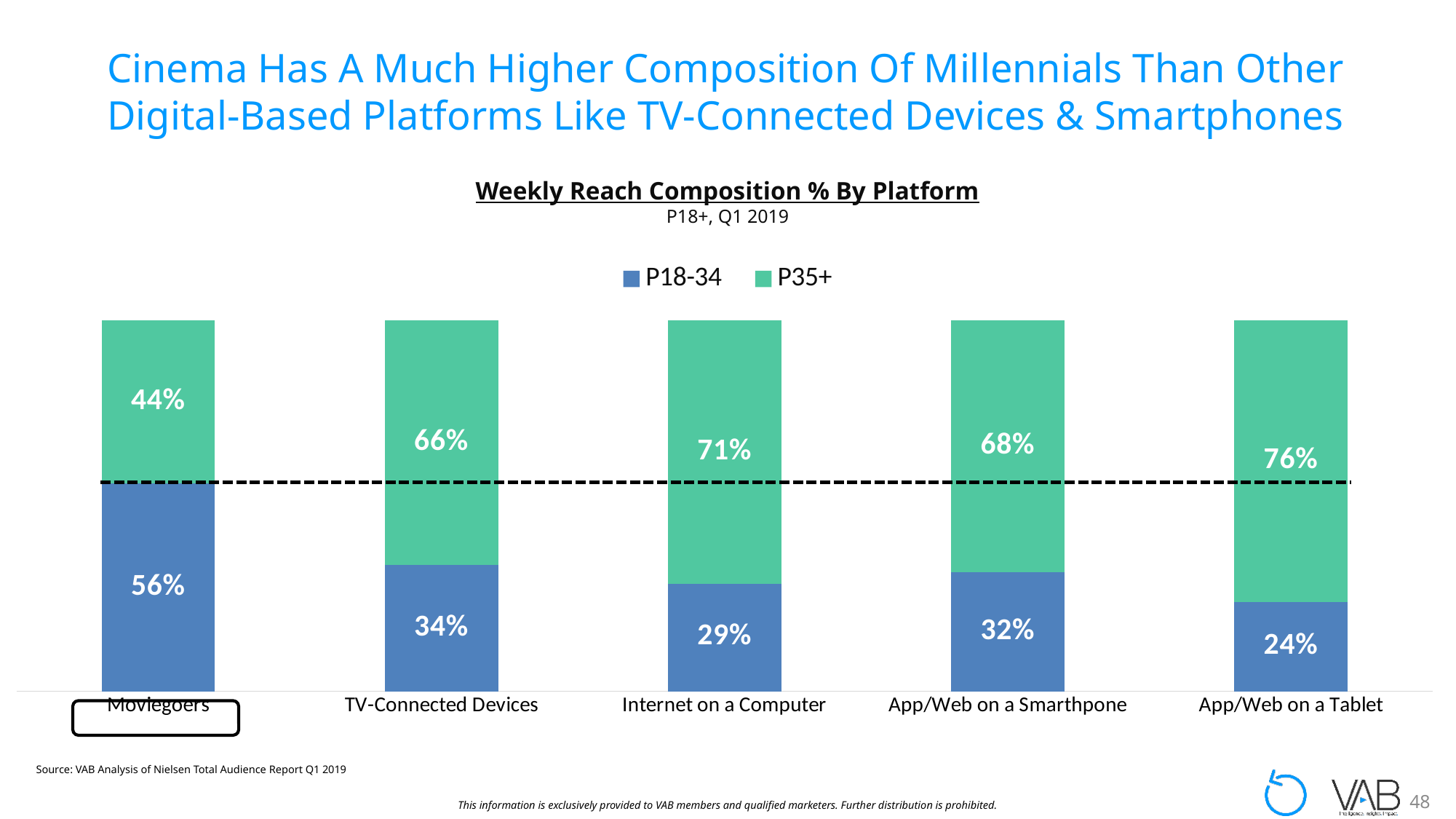
What is the P18-34 value for Moviegoers? 56% Which platform has the highest P18-34 share? Moviegoers What is the P18-34 value for Internet on a Computer? 29% What kind of chart is shown? Stacked bar chart What is the P35+ value for TV-Connected Devices? 66% How many platforms are shown on the x axis? 5 How many series does the legend list? 2 What is the total of the stacked bar for TV-Connected Devices? 100% What is the P35+ value for App/Web on a Tablet? 76% What is the difference between the P18-34 value for Moviegoers and the P18-34 value for App/Web on a Smarthpone? 24% Which is larger: the P35+ value for Internet on a Computer or the P35+ value for App/Web on a Smarthpone? Internet on a Computer Which platform has the lowest P18-34 share? App/Web on a Tablet